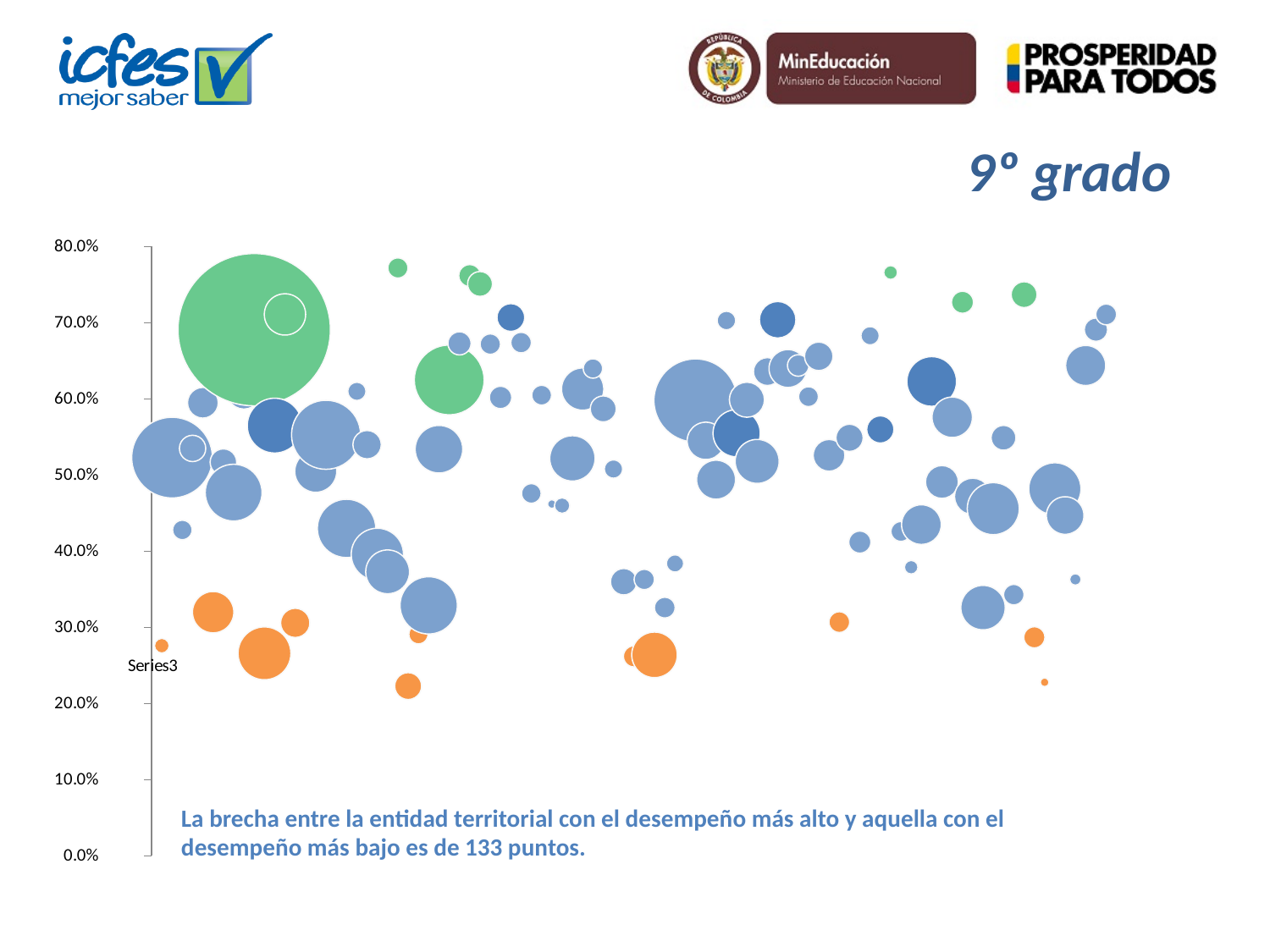
According to the text below the chart, how many points is the gap between the highest- and lowest-performing territorial entity? 133 puntos Are the orange bubbles positioned greater or less than 40.0% on the vertical axis? less What grade does the chart title refer to? 9º grado What kind of chart is shown on the slide? bubble chart Which colour of bubbles occupies the lowest positions on the vertical axis? orange Which colour of bubbles occupies the highest positions on the vertical axis? green Is the centre of the largest green bubble greater or less than 60.0% on the vertical axis? greater What is the highest value shown on the vertical axis of the chart? 80.0%